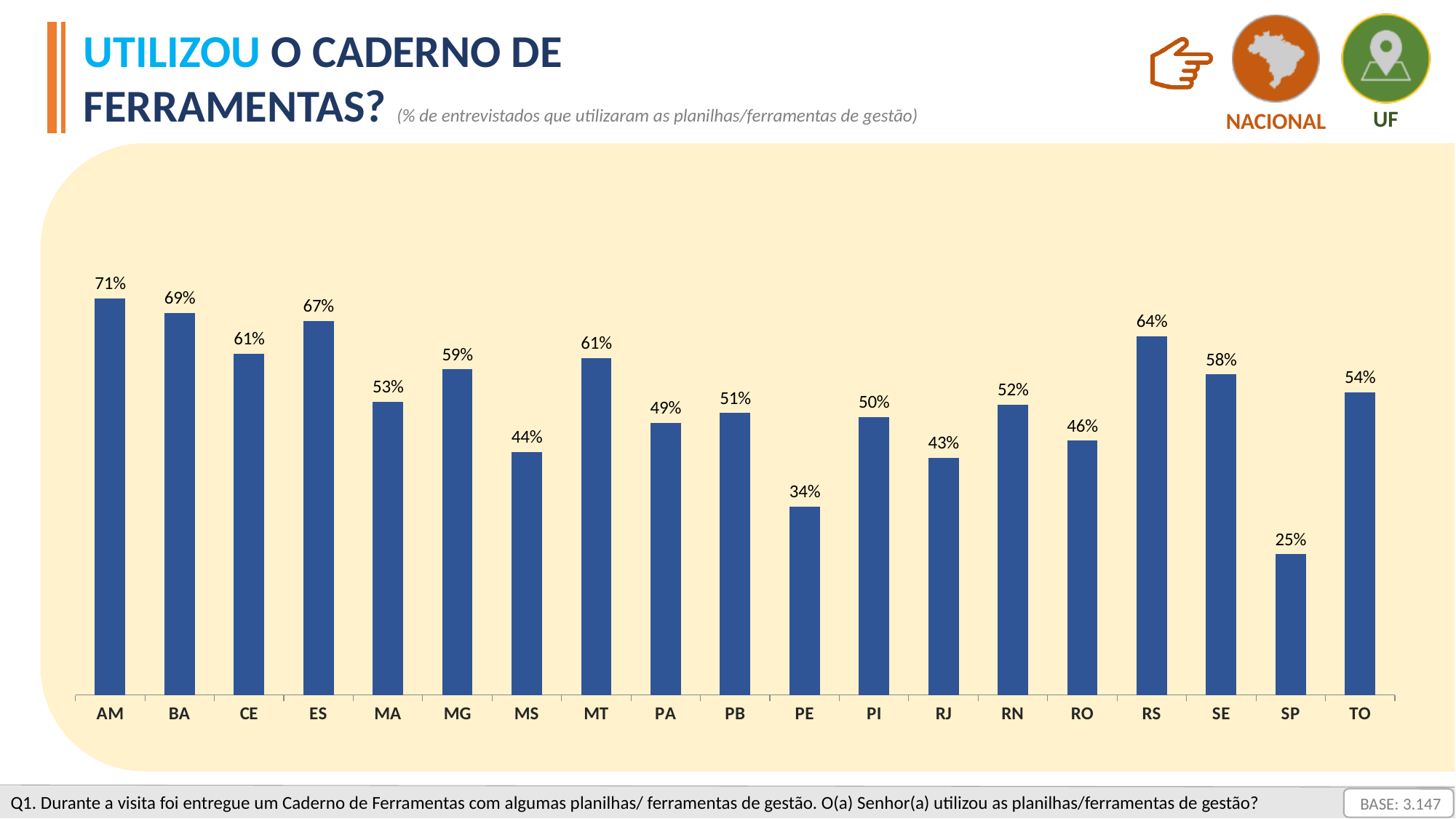
What kind of chart is shown on the slide? Bar chart What is the difference between the values for ES and MA? 14% What is the value for RS? 64% Which is larger, the value for RJ or the value for RO? RO What is the value for TO? 54% What is the value for MG? 59% What is the value for PE? 34% What is the difference between the values for AM and SP? 46% Which state has the highest value? AM Which is larger, the value for BA or the value for SE? BA Which state has the lowest value? SP How many states are shown on the x axis? 19